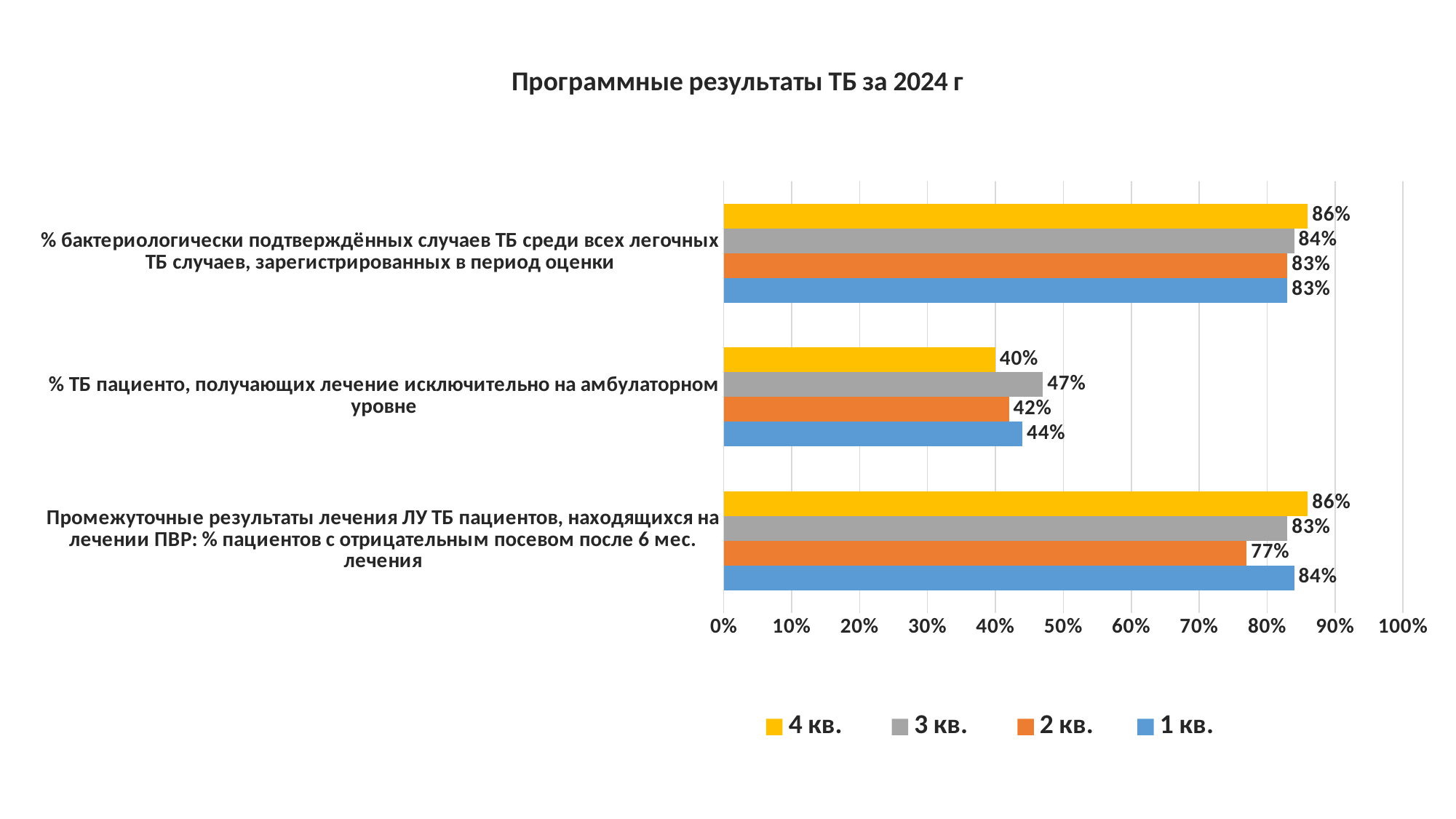
What is the value for 4 кв. in the category '% бактериологически подтверждённых случаев ТБ среди всех легочных ТБ случаев, зарегистрированных в период оценки'? 86% What is the value for 3 кв. in the category '% ТБ пациенто, получающих лечение исключительно на амбулаторном уровне'? 47% How many categories are shown on the chart? 3 Which quarter has the highest value in the category 'Промежуточные результаты лечения ЛУ ТБ пациентов, находящихся на лечении ПВР: % пациентов с отрицательным посевом после 6 мес. лечения'? 4 кв. How many series does the legend list? 4 What kind of chart is shown on the slide? bar chart Which quarter has the lowest value in the category '% ТБ пациенто, получающих лечение исключительно на амбулаторном уровне'? 4 кв. In the category '% ТБ пациенто, получающих лечение исключительно на амбулаторном уровне', which is larger: the value for 1 кв. or the value for 2 кв.? 1 кв. What is the title of the chart? Программные результаты ТБ за 2024 г What is the value for 2 кв. in the category 'Промежуточные результаты лечения ЛУ ТБ пациентов, находящихся на лечении ПВР: % пациентов с отрицательным посевом после 6 мес. лечения'? 77% Is the value for 3 кв. in the category '% ТБ пациенто, получающих лечение исключительно на амбулаторном уровне' greater or less than 50%? less What is the difference between the 1 кв. and 2 кв. values in the category 'Промежуточные результаты лечения ЛУ ТБ пациентов, находящихся на лечении ПВР: % пациентов с отрицательным посевом после 6 мес. лечения'? 7%